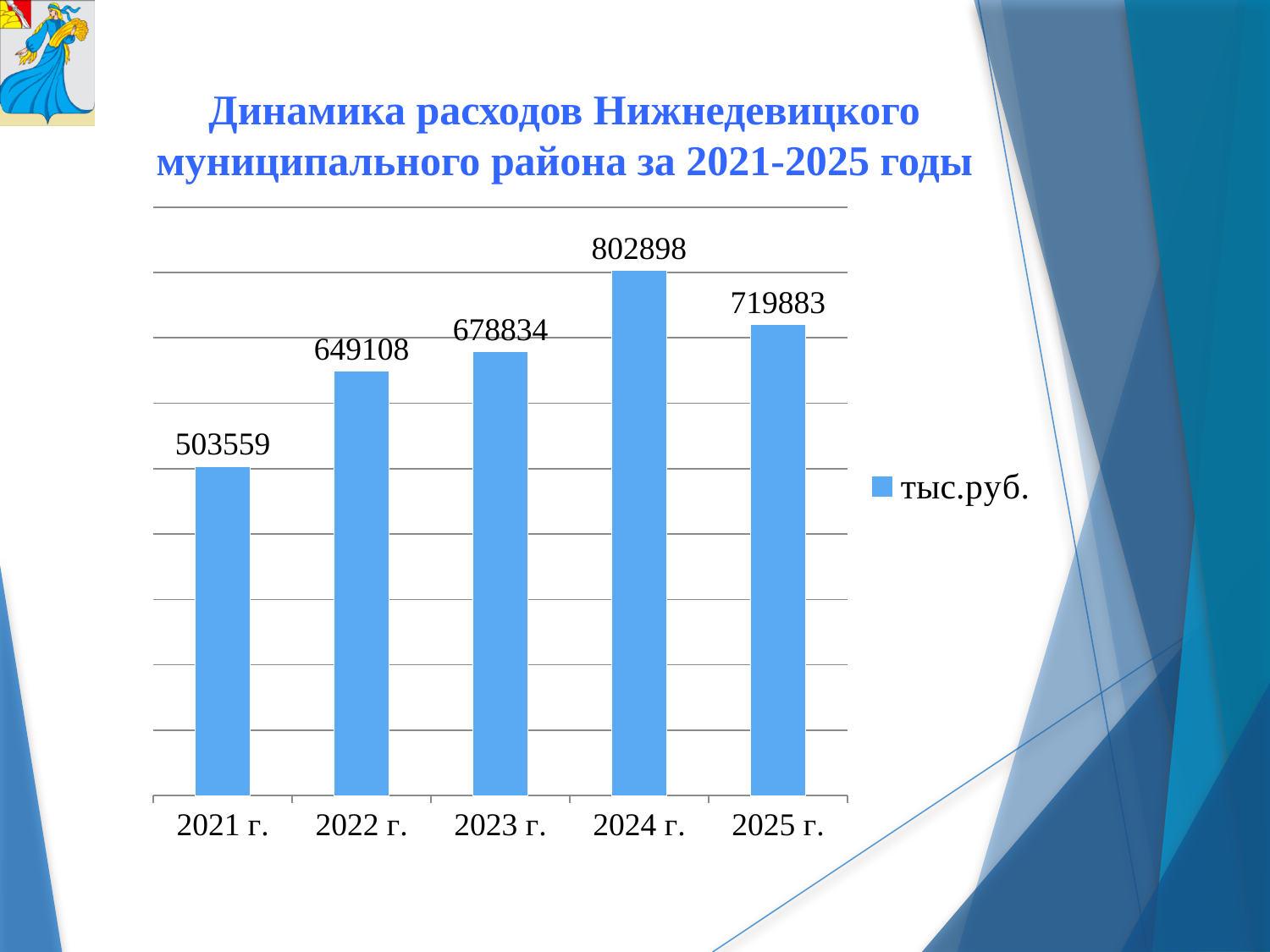
Which year has the lowest value? 2021 г. What is the difference between the values for 2024 г. and 2025 г.? 83015 What is the difference between the values for 2023 г. and 2022 г.? 29726 Which is larger, the value for 2023 г. or the value for 2025 г.? 2025 г. Which year has the highest value? 2024 г. What is the value for 2024 г.? 802898 What is the value for 2022 г.? 649108 What is the legend entry for the series? тыс.руб. What kind of chart is shown on the slide? bar chart What is the value for 2025 г.? 719883 How many years are shown on the x axis? 5 What is the value for 2021 г.? 503559